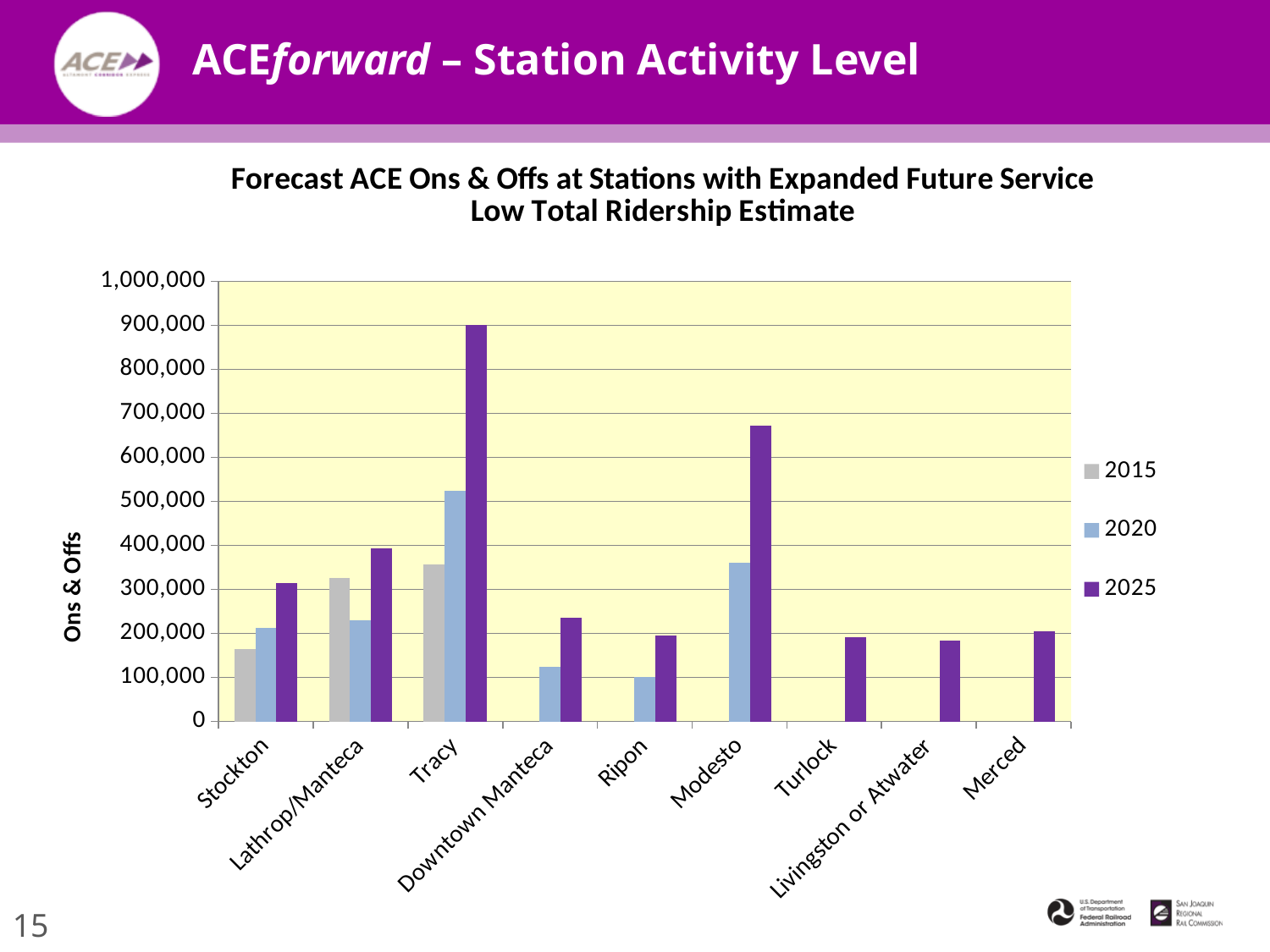
Is the 2025 value for Modesto greater or less than 600,000? greater Do the values for Tracy rise or fall from 2015 to 2025? Rise What kind of chart is shown on the slide? Bar chart How many stations are shown along the x axis of the chart? 9 Is the 2025 value for Tracy greater or less than 800,000? greater Which is larger, the 2025 value for Modesto or the 2025 value for Tracy? Tracy Which station has the highest 2025 value? Tracy Which station has the lowest 2015 value among those with a 2015 bar? Stockton Is the 2025 value for Lathrop/Manteca greater or less than 500,000? less How many series does the chart's legend list? 3 What is the title of the chart's vertical axis? Ons & Offs